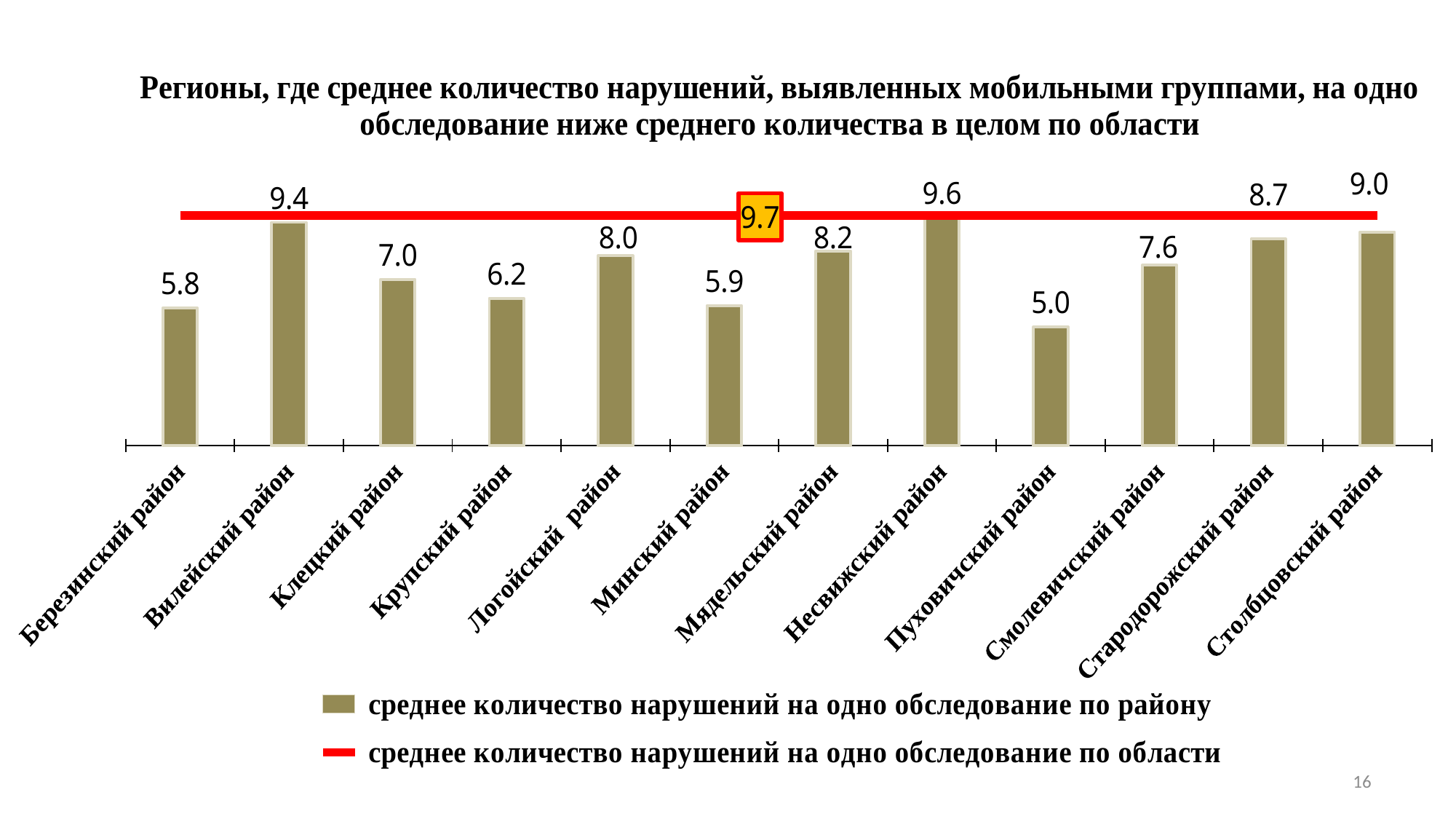
Which district has the highest average number of violations per inspection? Несвижский район How many series does the legend list? 2 How many districts are shown on the chart? 12 Which is larger, the value for Мядельский район or Логойский район? Мядельский район What is the regional average (по области) marked by the red line? 9.7 What value is shown for Несвижский район? 9.6 Which district has the lowest average number of violations per inspection? Пуховичский район Which is larger, the value for Крупский район or Смолевичский район? Смолевичский район What is the difference between the regional average of 9.7 and the value for Столбцовский район? 0.7 What kind of chart is shown on the slide? Combination bar and line chart What is the difference between the values for Вилейский район and Березинский район? 3.6 What is the average number of violations per inspection for Пуховичский район? 5.0